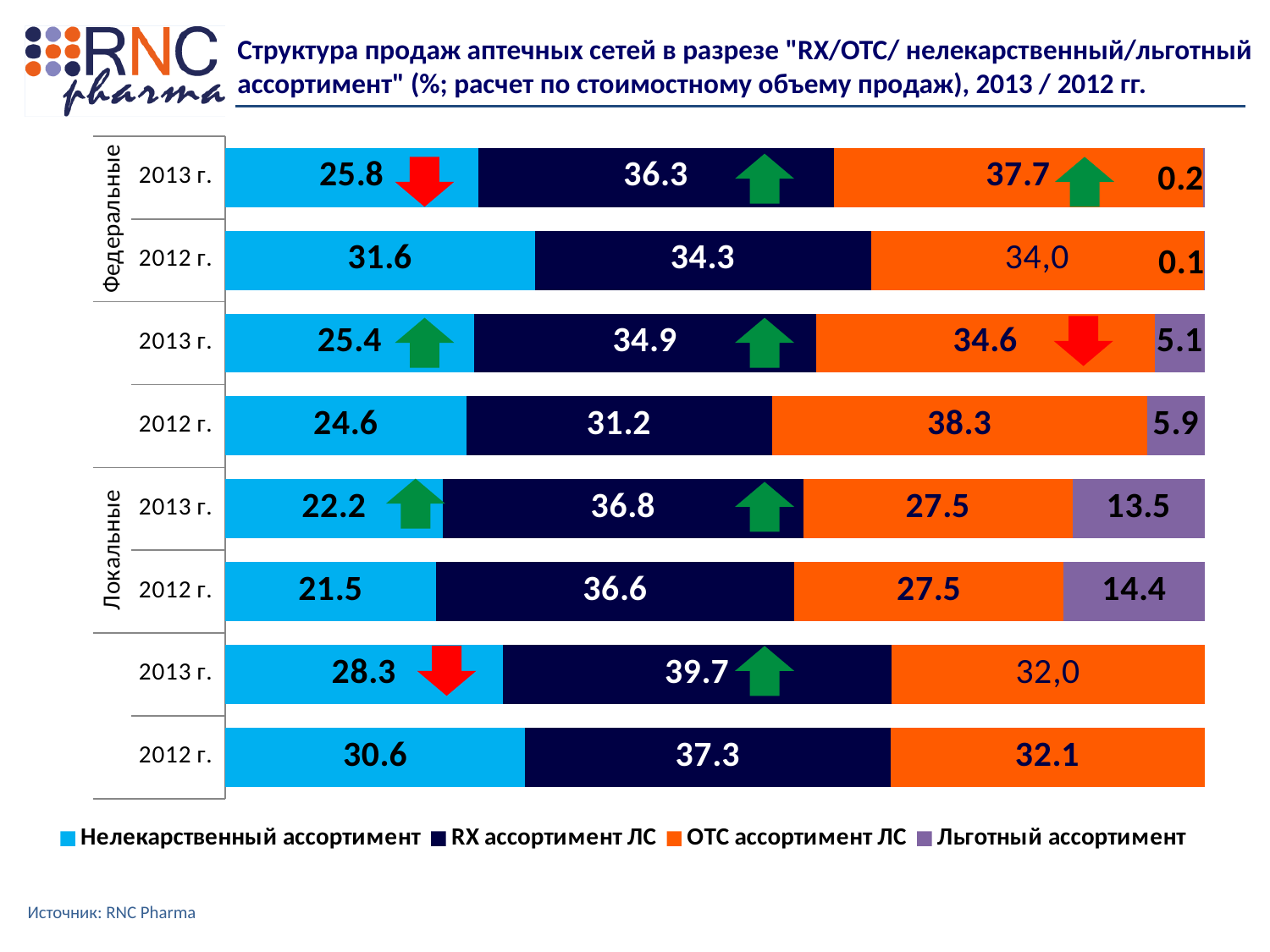
By how much did Льготный ассортимент for Локальные change from 2012 г. (14.4) to 2013 г. (13.5)? 0.9 How many bars are plotted in the chart? 8 In the Федеральные 2013 г. bar, which segment is the largest? ОТС ассортимент ЛС In the Федеральные 2013 г. bar, which is larger: RX ассортимент ЛС or ОТС ассортимент ЛС? ОТС ассортимент ЛС What is the difference between Нелекарственный ассортимент for Федеральные in 2012 г. and 2013 г.? 5.8 What kind of chart is shown on the slide? bar chart What is the value of Нелекарственный ассортимент for Федеральные, 2013 г.? 25.8 What is the value of ОТС ассортимент ЛС for Федеральные, 2012 г.? 34,0 What is the value of RX ассортимент ЛС for Локальные, 2012 г.? 36.6 How many series does the legend list? 4 What is the value of ОТС ассортимент ЛС in the bottom bar (2012 г.)? 32.1 What is the value of Льготный ассортимент for Локальные, 2013 г.? 13.5